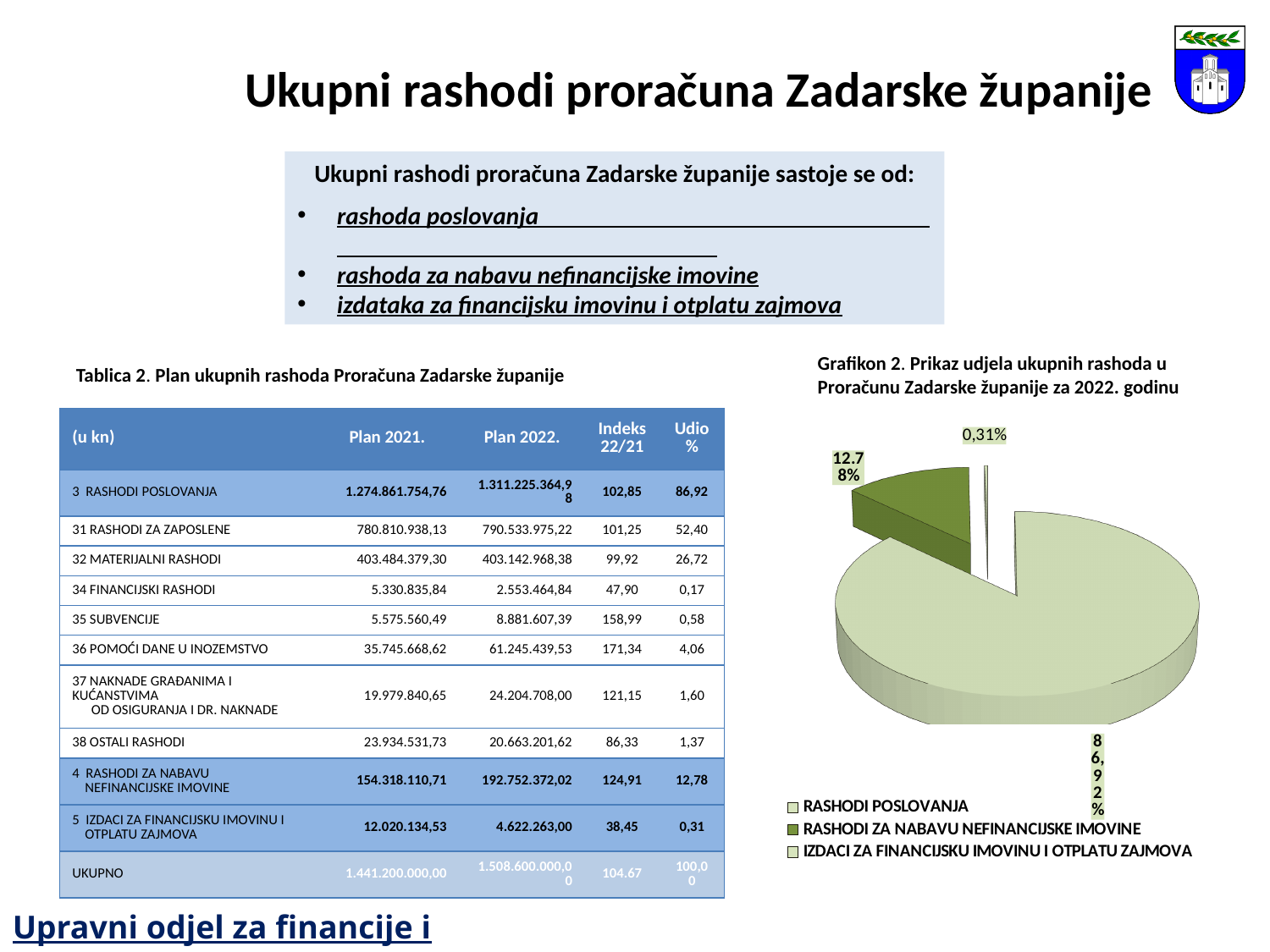
What is the title of the pie chart (Grafikon 2)? Prikaz udjela ukupnih rashoda u Proračunu Zadarske županije za 2022. godinu What share of the pie chart is labelled for RASHODI ZA NABAVU NEFINANCIJSKE IMOVINE? 12.78% What share of the pie chart is labelled for RASHODI POSLOVANJA? 86,92% Which legend entry of the pie chart is shown in the darkest green colour? RASHODI ZA NABAVU NEFINANCIJSKE IMOVINE What kind of chart is shown on the slide? pie chart Which category has the smallest slice in the pie chart? IZDACI ZA FINANCIJSKU IMOVINU I OTPLATU ZAJMOVA How many slices does the pie chart have? 3 What share of the pie chart is labelled for IZDACI ZA FINANCIJSKU IMOVINU I OTPLATU ZAJMOVA? 0,31% By how many percentage points does the RASHODI POSLOVANJA slice exceed the RASHODI ZA NABAVU NEFINANCIJSKE IMOVINE slice in the pie chart? 74,14 How many entries does the legend of the pie chart list? 3 In the pie chart, which is larger: the slice for RASHODI ZA NABAVU NEFINANCIJSKE IMOVINE or the slice for IZDACI ZA FINANCIJSKU IMOVINU I OTPLATU ZAJMOVA? RASHODI ZA NABAVU NEFINANCIJSKE IMOVINE Which category has the largest slice in the pie chart? RASHODI POSLOVANJA